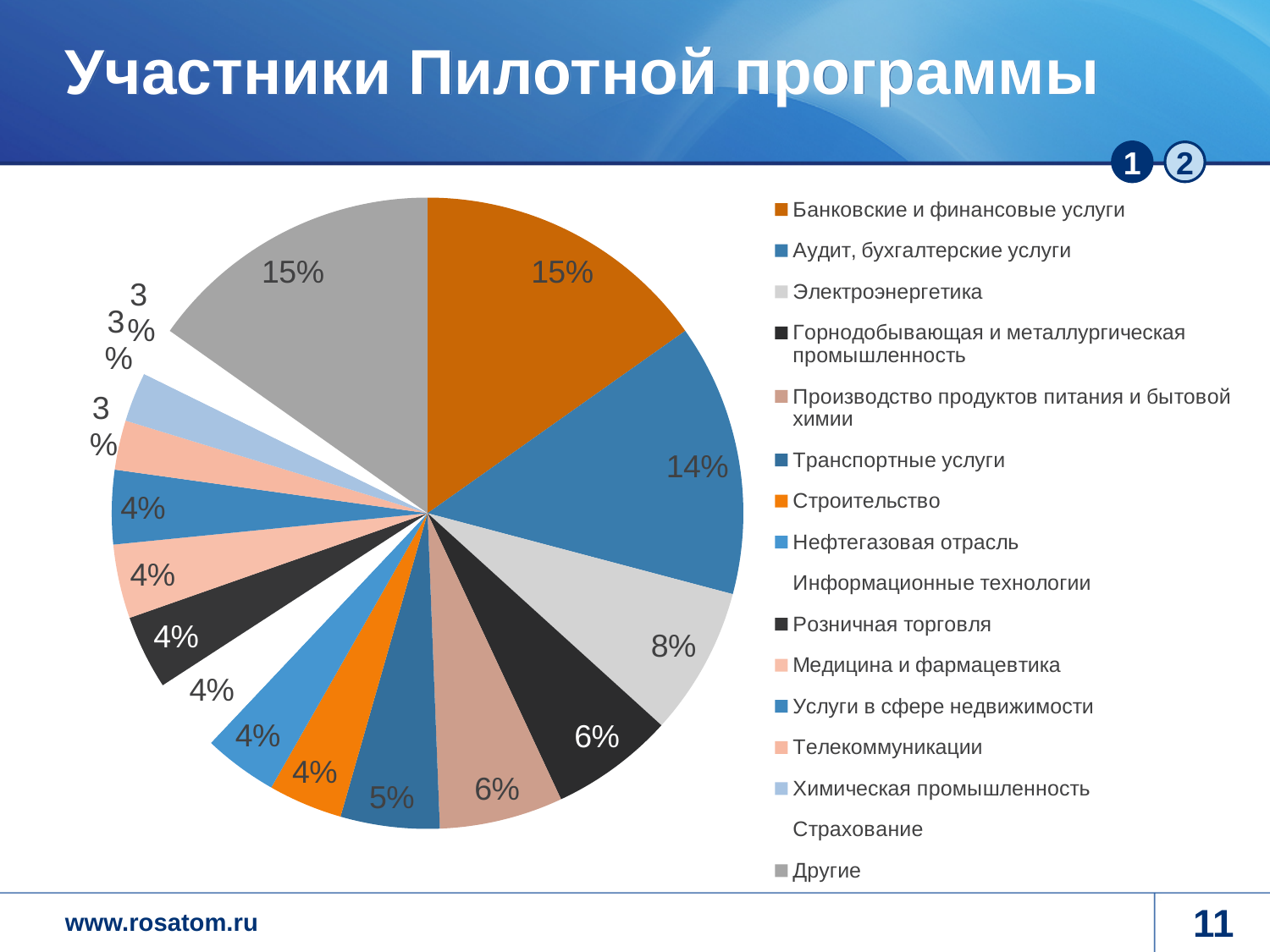
What percentage is shown for Аудит, бухгалтерские услуги? 14% How many categories does the legend list? 16 What is the value for Электроэнергетика? 8% What is the value for Горнодобывающая и металлургическая промышленность? 6% What share is labelled for Транспортные услуги? 5% What is the title of the slide? Участники Пилотной программы Which is larger, Аудит, бухгалтерские услуги or Электроэнергетика? Аудит, бухгалтерские услуги What is the difference between Банковские и финансовые услуги and Транспортные услуги? 10% What share of the pie does Банковские и финансовые услуги hold? 15% What kind of chart is shown on the slide? Pie chart What percentage does the Другие slice show? 15% What is the difference between the shares of Аудит, бухгалтерские услуги and Электроэнергетика? 6%